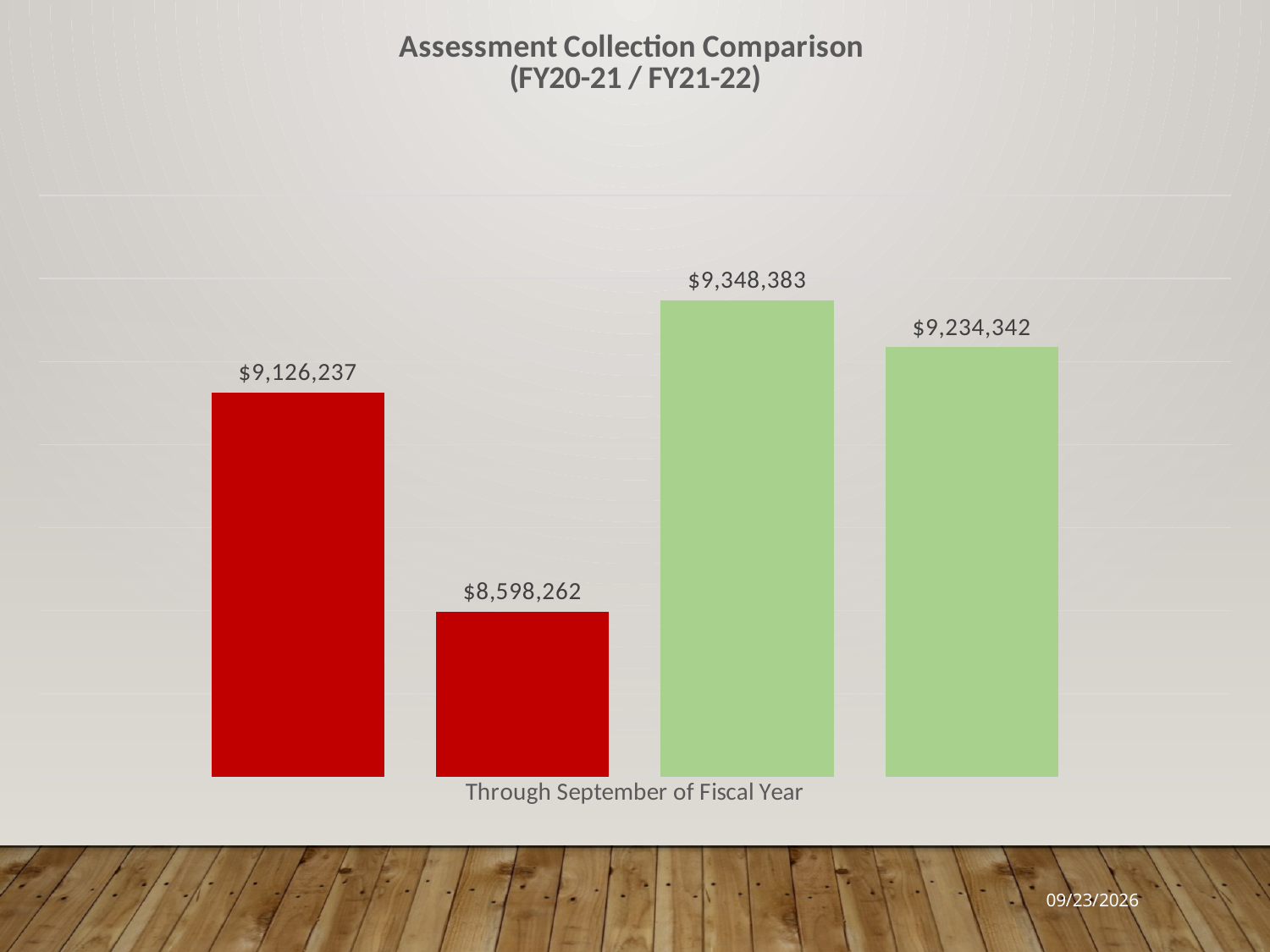
What is the value of the second bar from the left? $8,598,262 What is the value of the third bar from the left? $9,348,383 What is the label shown beneath the bars along the x axis? Through September of Fiscal Year How many bars are plotted in the chart? 4 What is the title of the chart? Assessment Collection Comparison (FY20-21 / FY21-22) Which is larger, the first bar or the second bar? the first bar ($9,126,237) What is the lowest value shown in the chart? $8,598,262 What is the value of the leftmost (first) bar? $9,126,237 What is the highest value shown in the chart? $9,348,383 What is the value of the rightmost (fourth) bar? $9,234,342 What type of chart is shown on the slide? bar chart What is the difference between the third bar ($9,348,383) and the fourth bar ($9,234,342)? $114,041